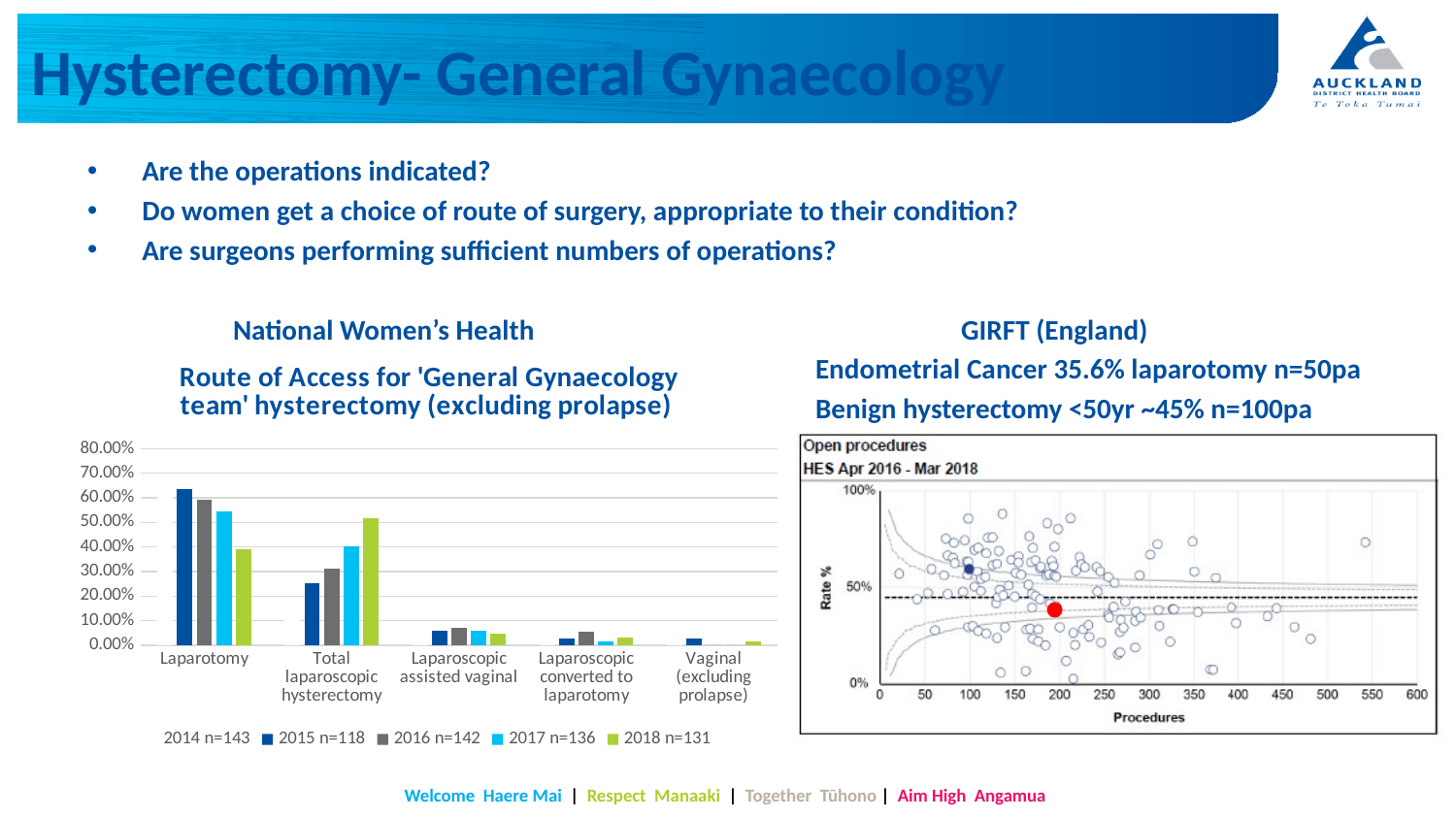
In the 'Route of Access' bar chart, is the 2018 value for Total laparoscopic hysterectomy greater or less than 40.00%? greater How many series does the legend of the 'Route of Access' bar chart list? 5 In the 'Route of Access' bar chart, is the 2018 value for Laparoscopic assisted vaginal greater or less than 10.00%? less In the 'Route of Access' bar chart, which is larger for 2018: Laparotomy or Total laparoscopic hysterectomy? Total laparoscopic hysterectomy In the 'Route of Access' bar chart, is the 2018 value for Laparotomy greater or less than 30.00%? greater What kind of chart is the 'Route of Access for General Gynaecology team hysterectomy' chart on the left? bar chart How many categories are shown on the x axis of the 'Route of Access' bar chart? 5 In the 'Route of Access' bar chart, what is the n value given in the legend for 2017? n=136 In the 'Route of Access' bar chart, which category has the highest 2018 value? Total laparoscopic hysterectomy In the 'Route of Access' bar chart, do the Laparotomy values rise or fall from the earliest to the latest year? fall